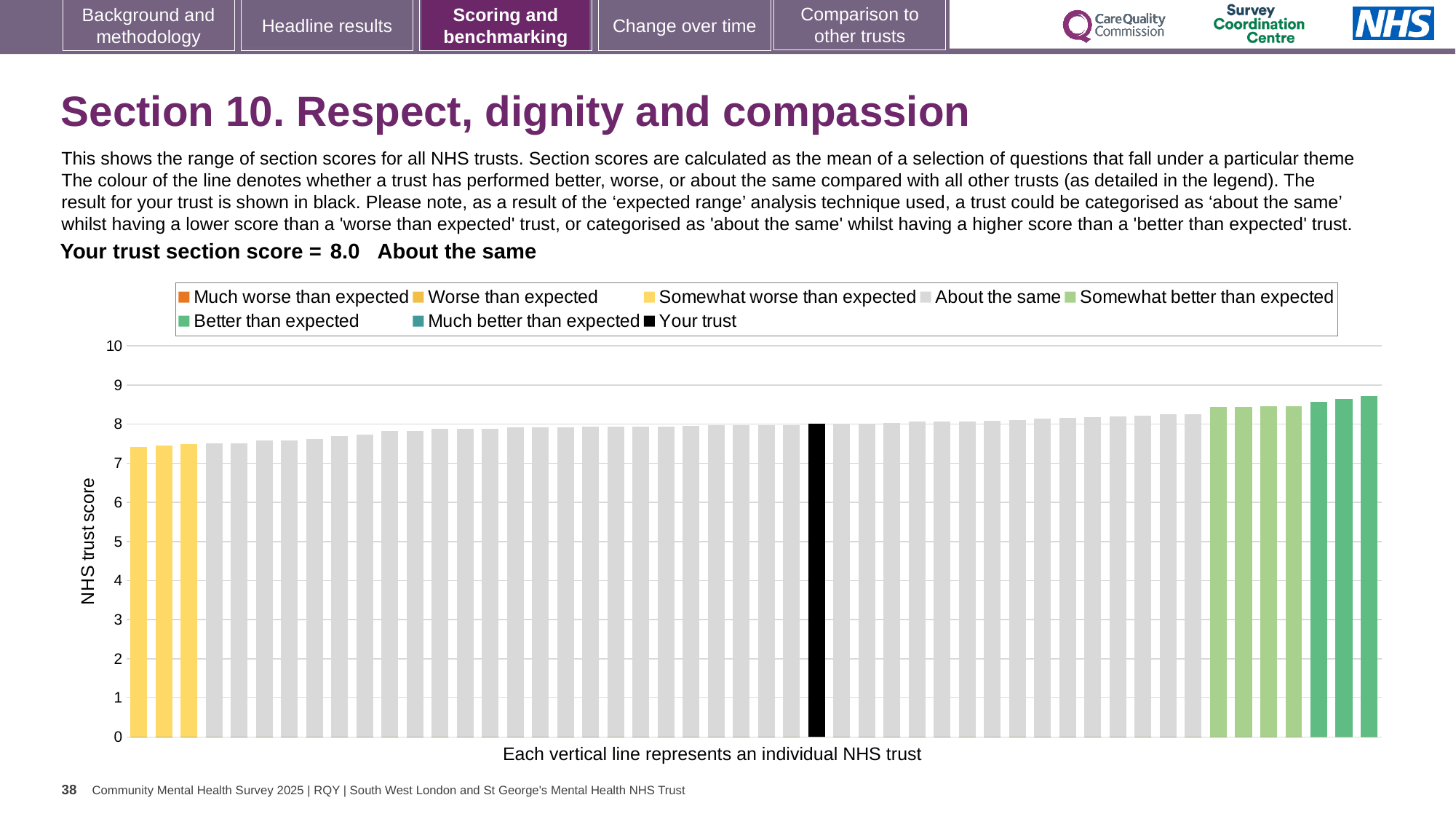
What kind of chart is shown on the slide? bar chart Which is higher, the leftmost bar or the rightmost bar? the rightmost bar What colour is the bar representing your trust? black Do the bar values rise or fall from left to right along the x axis? rise How many bars are coloured dark green (Better than expected)? 3 Is the value of the leftmost bar greater or less than 8? less Is the value of the tallest bar greater or less than 8? greater What is the title of the vertical axis? NHS trust score How many entries does the chart legend list? 8 What is the section score for your trust shown on the slide? 8.0 Is the value for your trust greater or less than 5? greater